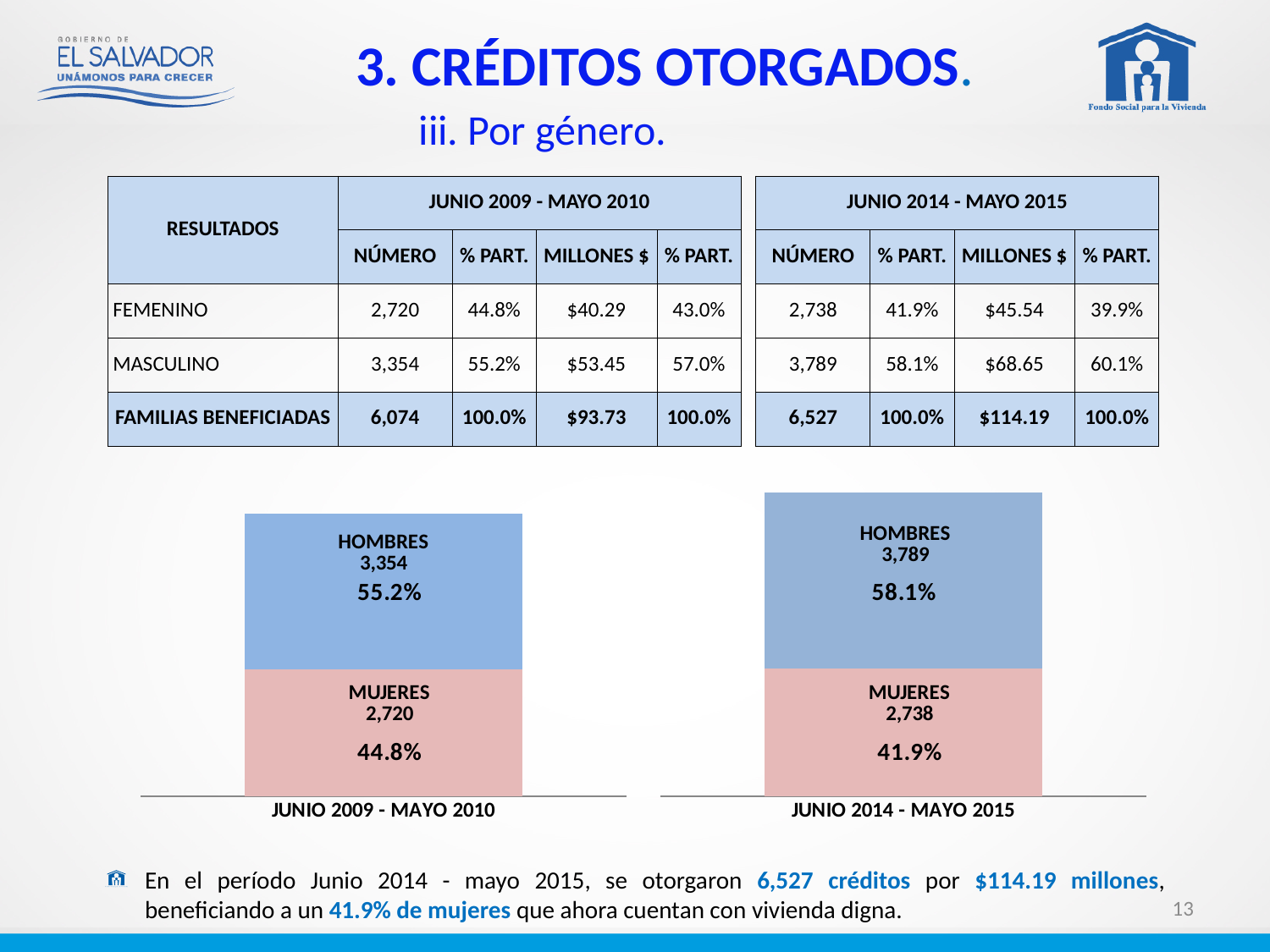
In the right chart (JUNIO 2014 - MAYO 2015), what colour is the MUJERES segment? Pink In the right chart (JUNIO 2014 - MAYO 2015), what percentage is shown for MUJERES? 41.9% In the left chart (JUNIO 2009 - MAYO 2010), what is the total of the stacked bar (HOMBRES plus MUJERES)? 6,074 What kind of chart is used for the two gender charts on the slide? Stacked bar chart In the right chart (JUNIO 2014 - MAYO 2015), what is the total of the stacked bar (HOMBRES plus MUJERES)? 6,527 In the left chart (JUNIO 2009 - MAYO 2010), which segment is larger, HOMBRES or MUJERES? HOMBRES In the right chart (JUNIO 2014 - MAYO 2015), what is the value for HOMBRES? 3,789 In the left chart (JUNIO 2009 - MAYO 2010), what is the value for MUJERES? 2,720 In the left chart (JUNIO 2009 - MAYO 2010), what percentage is shown for HOMBRES? 55.2% In the left chart (JUNIO 2009 - MAYO 2010), what is the value for HOMBRES? 3,354 In the right chart (JUNIO 2014 - MAYO 2015), what is the value for MUJERES? 2,738 In the right chart (JUNIO 2014 - MAYO 2015), what is the difference between the HOMBRES and MUJERES values? 1,051